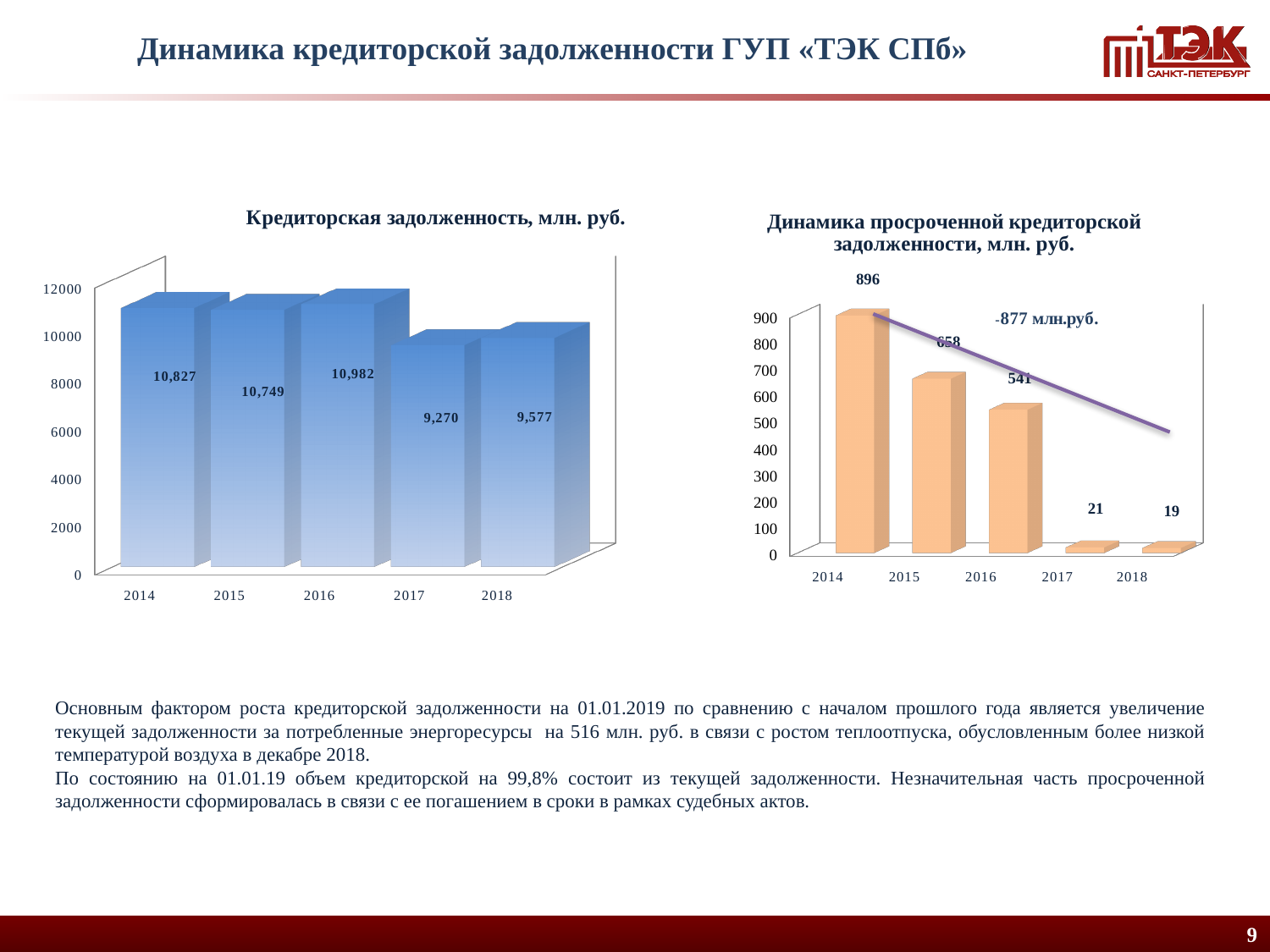
In the chart titled "Кредиторская задолженность, млн. руб.", what is the value for 2016? 10,982 In the chart titled "Кредиторская задолженность, млн. руб.", which year has the lowest value? 2017 In the chart titled "Кредиторская задолженность, млн. руб.", what is the value for 2017? 9,270 In the chart titled "Кредиторская задолженность, млн. руб.", what is the difference between the values for 2018 and 2017? 307 In the chart titled "Динамика просроченной кредиторской задолженности, млн. руб.", is the value for 2016 greater or less than 500? greater In the chart titled "Кредиторская задолженность, млн. руб.", how many years are shown on the x axis? 5 In the chart titled "Динамика просроченной кредиторской задолженности, млн. руб.", what is the value for 2018? 19 In the chart titled "Динамика просроченной кредиторской задолженности, млн. руб.", what is the difference between the values for 2014 and 2015? 238 In the chart titled "Динамика просроченной кредиторской задолженности, млн. руб.", what is the value for 2014? 896 In the chart titled "Динамика просроченной кредиторской задолженности, млн. руб.", do the values rise or fall from 2014 to 2018? fall What kind of chart is the chart titled "Динамика просроченной кредиторской задолженности, млн. руб."? bar chart In the chart titled "Кредиторская задолженность, млн. руб.", which year has the highest value? 2016